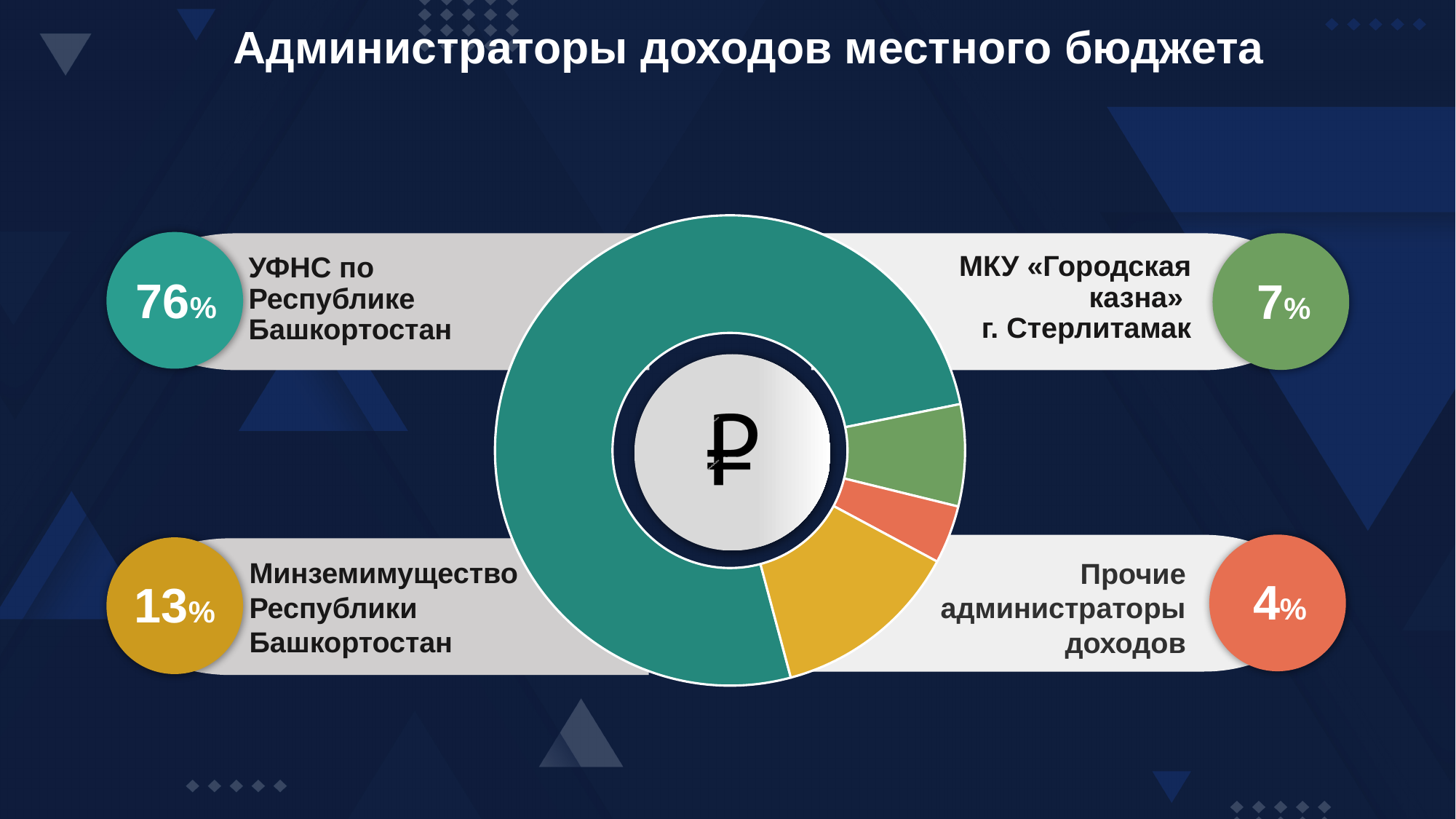
Which revenue administrator has the largest share of the chart? УФНС по Республике Башкортостан What is the difference in percentage points between the shares of УФНС по Республике Башкортостан and Минземимущество Республики Башкортостан? 63 What share is attributed to Минземимущество Республики Башкортостан? 13% What share of local budget revenue is administered by УФНС по Республике Башкортостан? 76% What kind of chart is shown on the slide? Donut (pie) chart What share is attributed to Прочие администраторы доходов? 4% Which revenue administrator has the smallest share of the chart? Прочие администраторы доходов Which has a larger share: МКУ «Городская казна» г. Стерлитамак or Прочие администраторы доходов? МКУ «Городская казна» г. Стерлитамак How many segments does the chart have? 4 What is the title of the slide? Администраторы доходов местного бюджета What share is attributed to МКУ «Городская казна» г. Стерлитамак? 7% What colour is the segment for Минземимущество Республики Башкортостан? Yellow